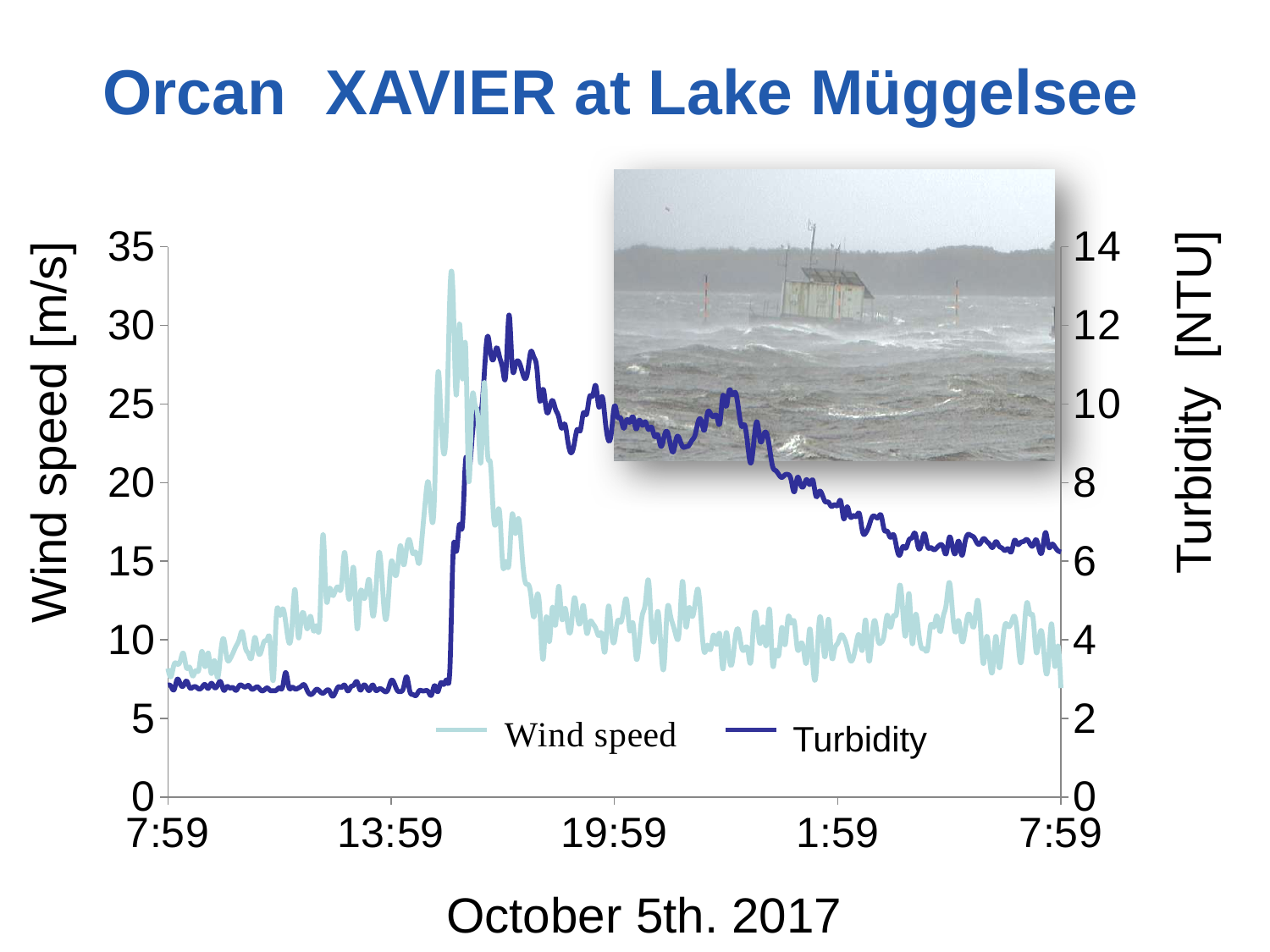
Is the peak turbidity value greater or less than 10 NTU? greater Does the turbidity rise or fall between 19:59 and the final 7:59 reading? fall Is the wind speed at 1:59 greater or less than 20 m/s? less Is the turbidity value at the end of the record (7:59 the next morning) greater or less than 8 NTU? less What are the two series named in the legend? Wind speed and Turbidity How many series does the legend list? 2 What is the title of the slide's chart? Orcan XAVIER at Lake Müggelsee What kind of chart is shown on the slide? line chart Does the wind speed rise or fall between 7:59 and 13:59? rise How many time labels are shown on the x axis? 5